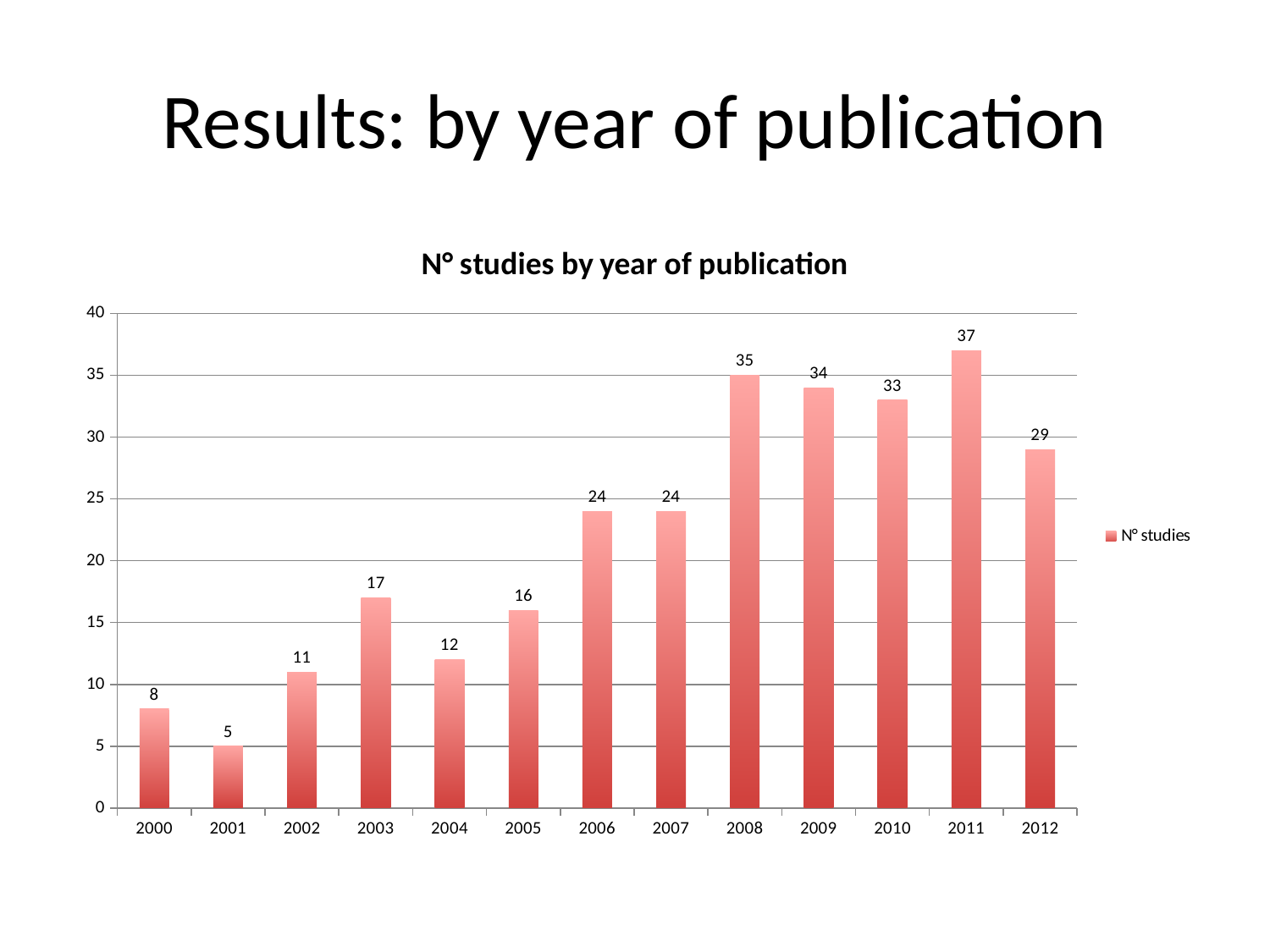
What is the difference between the number of studies in 2011 and in 2012? 8 Which year has the lowest number of studies? 2001 What kind of chart is shown on the slide? Bar chart What is the number of studies published in 2008? 35 How many years are shown on the x axis? 13 Which year has the highest number of studies? 2011 What is the number of studies published in 2003? 17 Do the values generally rise or fall from 2001 to 2008? Rise What is the title of the chart? N° studies by year of publication How many series does the legend list? 1 Which year has more studies, 2006 or 2009? 2009 Is the value for 2010 greater or less than 30? greater